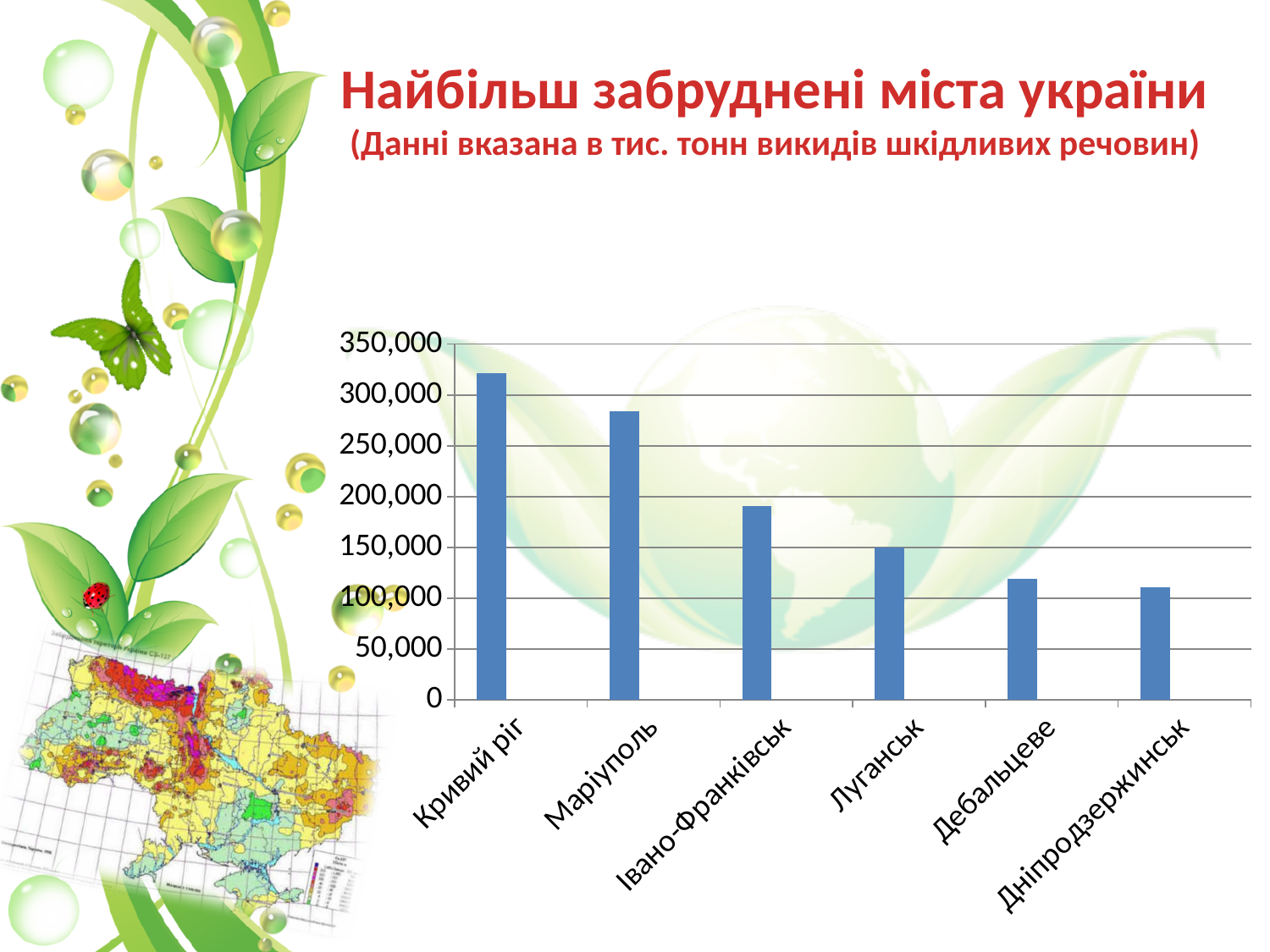
Is the value for Івано-Франківськ greater or less than 200,000? less Is the value for Кривий ріг greater or less than 300,000? greater Is the value for Маріуполь greater or less than 300,000? less Do the values rise or fall from left to right along the x axis? fall Which is larger, the value for Маріуполь or the value for Івано-Франківськ? Маріуполь How many cities are shown on the chart? 6 What is the title of the slide above the chart? Найбільш забруднені міста україни Which city has the highest value on the chart? Кривий ріг Which city has the lowest value on the chart? Дніпродзержинськ What kind of chart is shown on the slide? bar chart